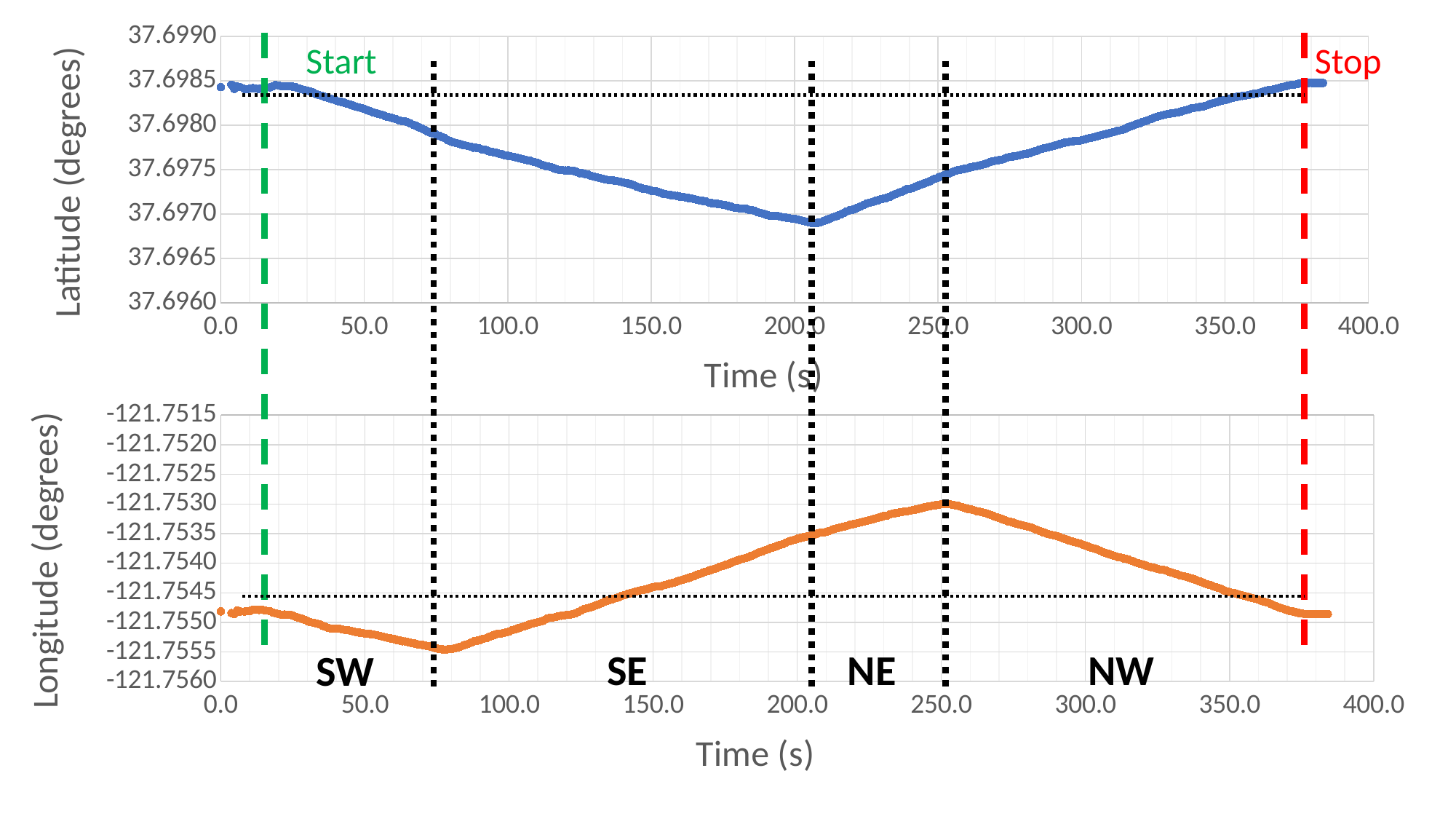
In the top chart, is the latitude at 300 s greater or less than 37.6980? less In the top chart, does the latitude rise or fall between 50 s and 200 s? fall In the bottom chart, is the longitude at 100 s greater or less than -121.7545? less In the top chart, does the latitude rise or fall between 250 s and 350 s? rise In the top chart, is the latitude at 100 s greater or less than 37.6980? less In the bottom chart, what are the four direction labels written along the bottom of the plot, from left to right? SW, SE, NE, NW In the bottom chart, does the longitude rise or fall between 250 s and 350 s? fall In the bottom chart, is the longitude higher at 75 s or at 250 s? 250 s In the top chart, is the latitude higher at 100 s or at 200 s? 100 s In the top chart, what is the label on the vertical axis? Latitude (degrees)